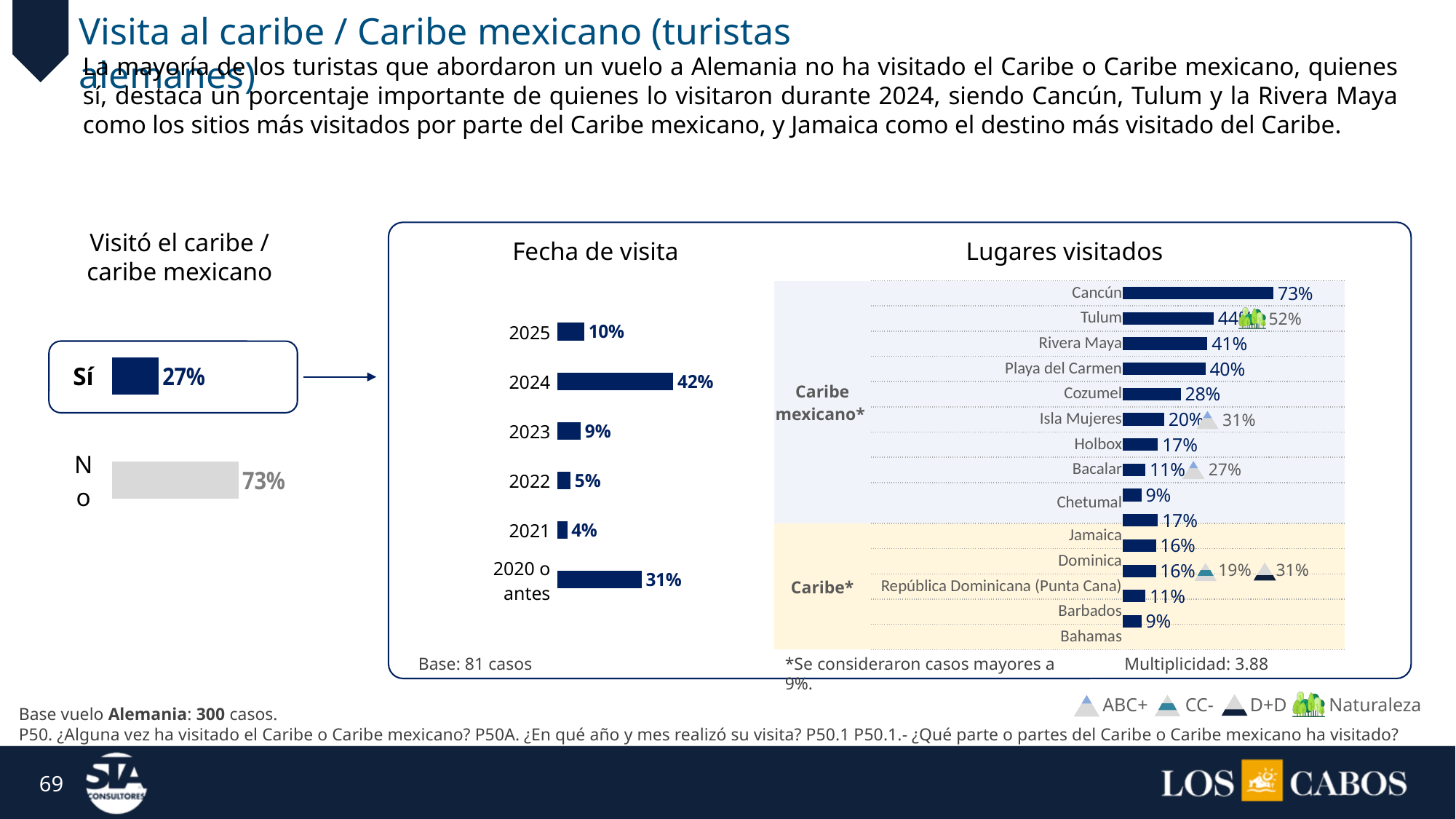
In the 'Visitó el caribe / caribe mexicano' chart, what percentage answered Sí? 27% In the 'Fecha de visita' chart, which year has the lowest value? 2021 In the 'Fecha de visita' chart, what is the value for 2024? 42% In the 'Lugares visitados' chart, what is the value for Cancún? 73% In the 'Lugares visitados' chart, which place has the highest value? Cancún In the 'Fecha de visita' chart, what is the value for 2020 o antes? 31% What type of chart is the 'Fecha de visita' chart? Bar chart In the 'Visitó el caribe / caribe mexicano' chart, what percentage answered No? 73% In the 'Lugares visitados' chart, which is larger, Rivera Maya or Holbox? Rivera Maya In the 'Lugares visitados' chart, what is the value for Cozumel? 28% In the 'Fecha de visita' chart, what is the difference between the values for 2024 and 2025? 32% In the 'Fecha de visita' chart, how many year categories are shown? 6